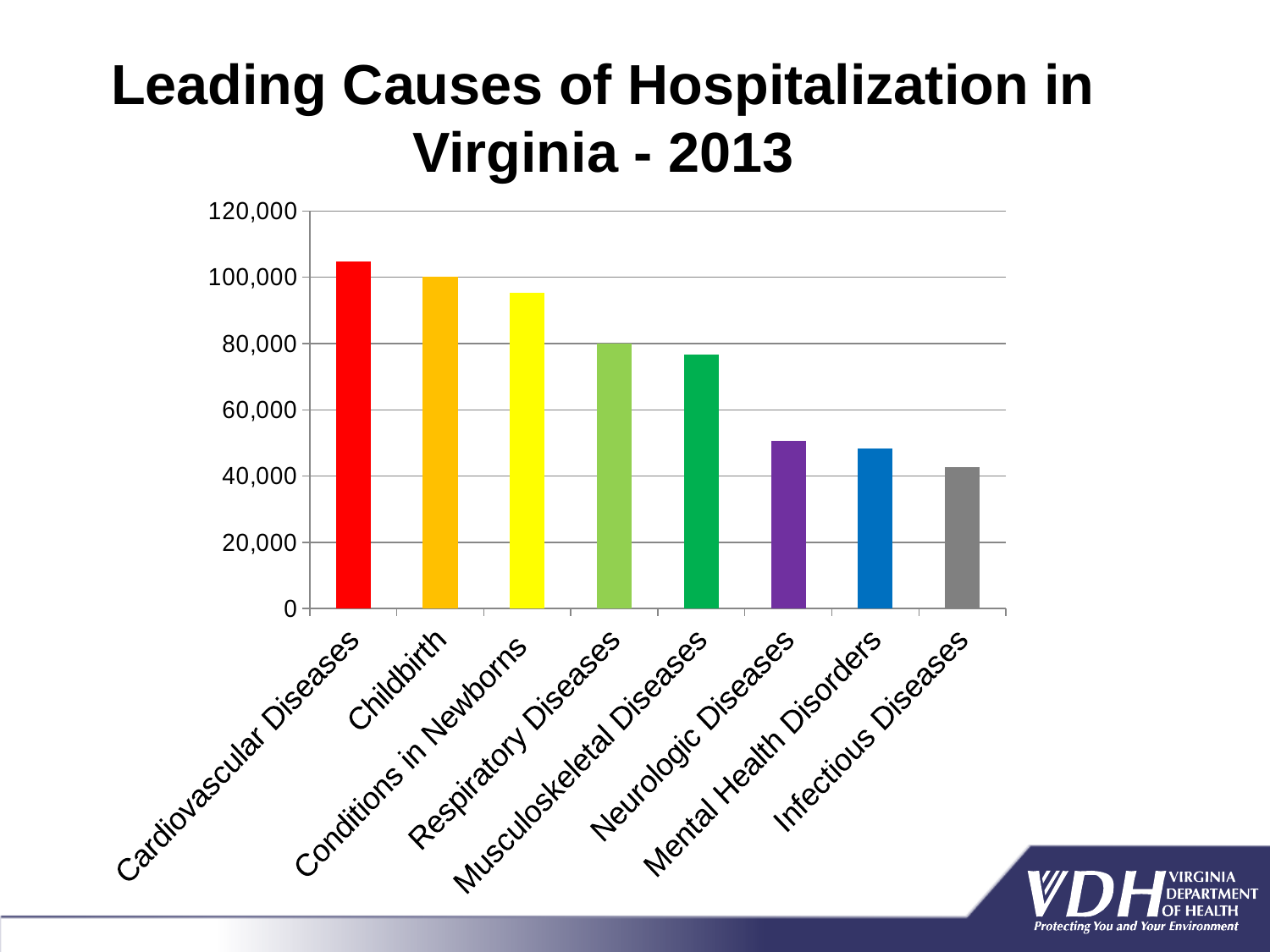
Is the value for Cardiovascular Diseases greater or less than 100,000? greater Is the value for Musculoskeletal Diseases greater or less than 80,000? less What is the title of the chart? Leading Causes of Hospitalization in Virginia - 2013 Which cause of hospitalization has the lowest value? Infectious Diseases Which cause of hospitalization has the highest value? Cardiovascular Diseases What kind of chart is shown on the slide? bar chart Is the value for Conditions in Newborns greater or less than 80,000? greater How many causes of hospitalization are shown on the chart? 8 Which is larger, the value for Childbirth or the value for Respiratory Diseases? Childbirth Do the values rise or fall moving from left to right across the categories? fall